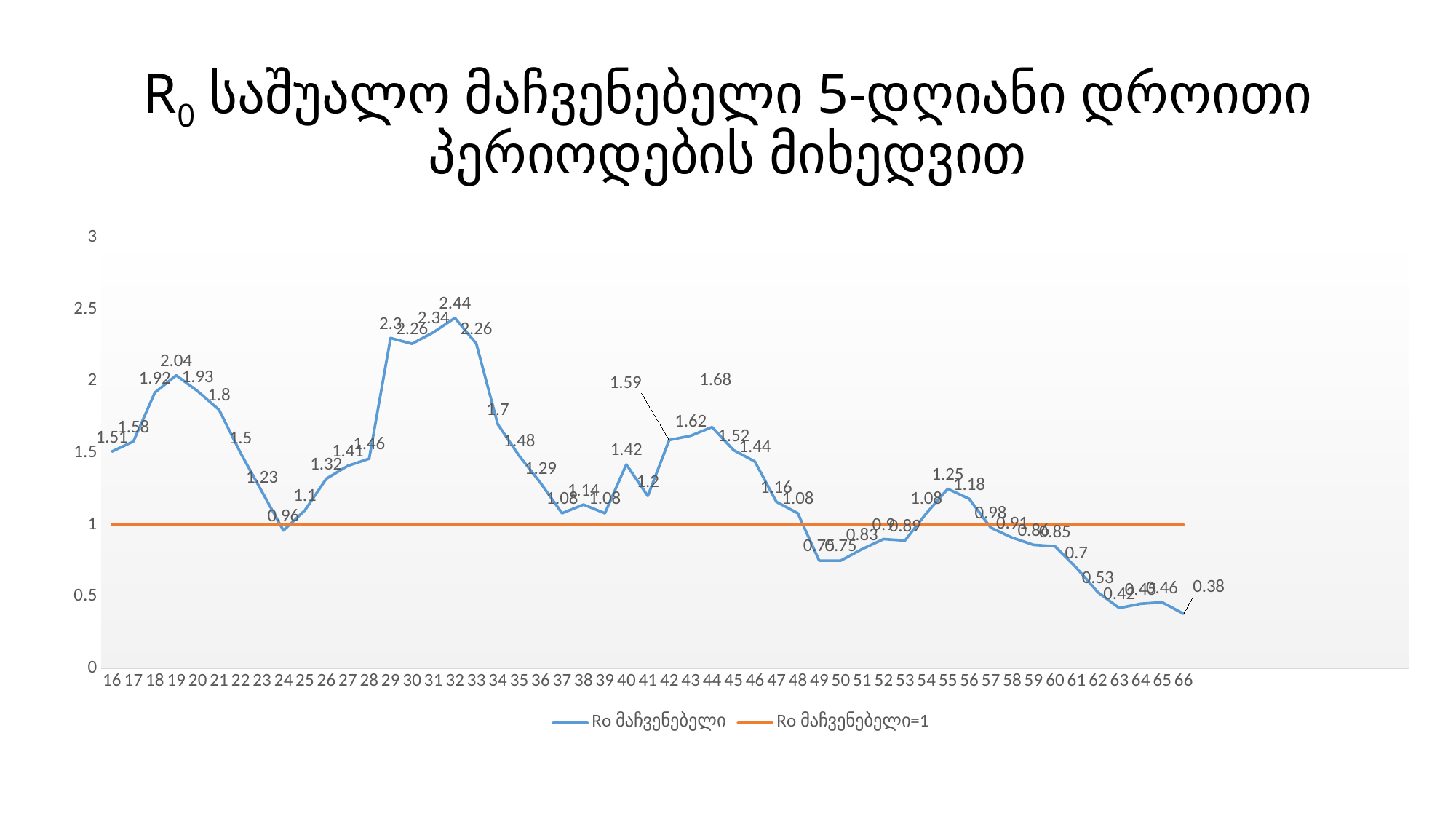
What is the value of Ro მაჩვენებელი at period 66? 0.38 At which period does Ro მაჩვენებელი reach its highest value? 32 What is the value of Ro მაჩვენებელი at period 19? 2.04 Which is larger, the Ro მაჩვენებელი value at period 29 or at period 34? period 29 At which period does Ro მაჩვენებელი reach its lowest value? 66 What is the value of Ro მაჩვენებელი at period 44? 1.68 How many series does the legend list? 2 What is the value of Ro მაჩვენებელი at period 32? 2.44 What is the difference between the Ro მაჩვენებელი values at period 32 and period 19? 0.4 Is the value of Ro მაჩვენებელი at period 24 greater or less than 1? less What type of chart is shown on the slide? line chart What is the constant value of the orange reference line, Ro მაჩვენებელი=1? 1